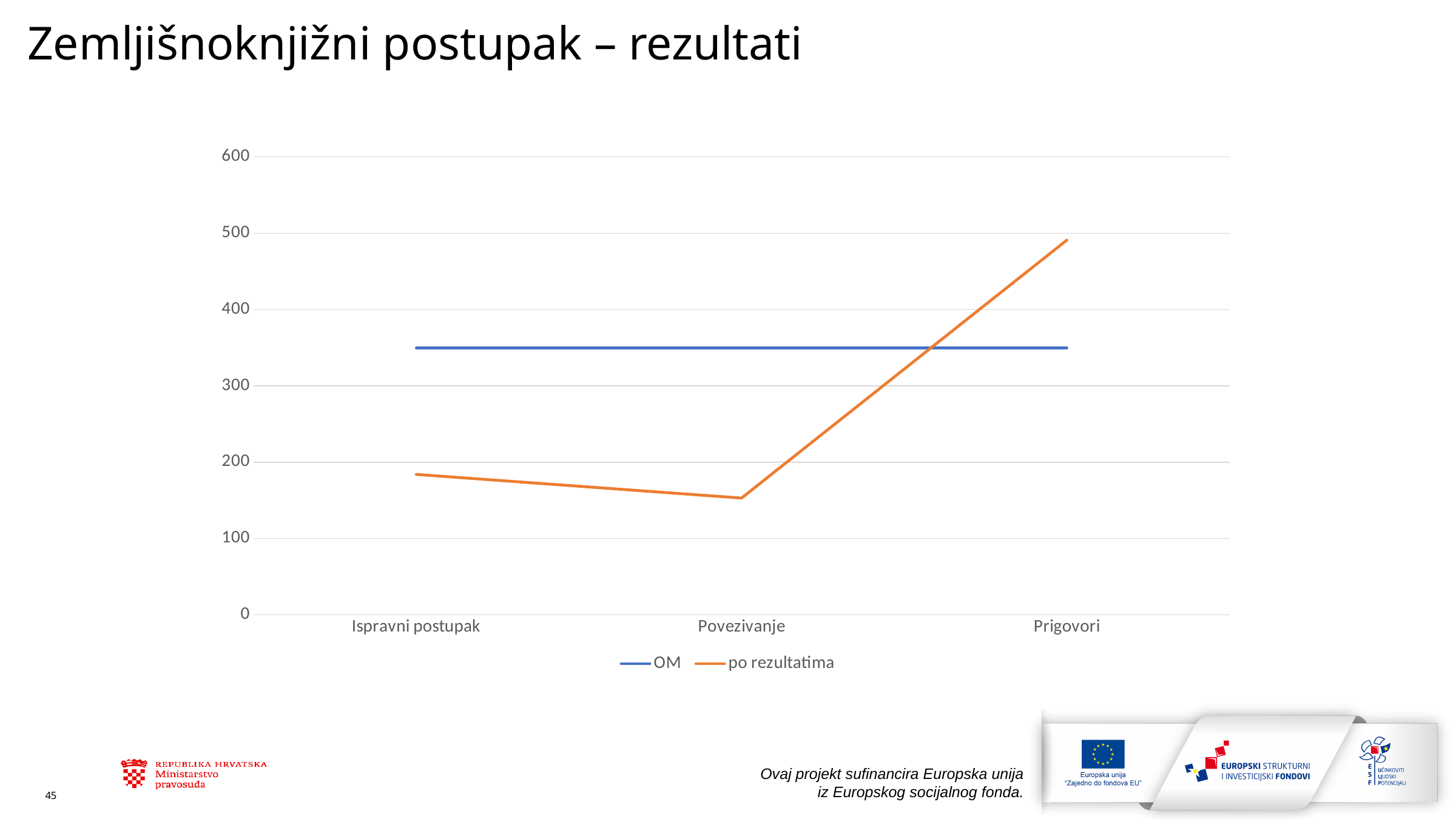
Is the value for 'po rezultatima' at Povezivanje greater or less than 200? less Which category has the lowest value for the 'po rezultatima' series? Povezivanje Is the value for 'OM' at Ispravni postupak greater or less than 300? greater How many categories are shown on the x axis? 3 Is the value for 'po rezultatima' at Prigovori greater or less than 400? greater How many series does the legend list? 2 At Ispravni postupak, which series has the larger value, 'OM' or 'po rezultatima'? OM What kind of chart is shown on the slide? line chart Which category has the highest value for the 'po rezultatima' series? Prigovori At Prigovori, which series has the larger value, 'OM' or 'po rezultatima'? po rezultatima Does the 'po rezultatima' series rise or fall from Povezivanje to Prigovori? rise